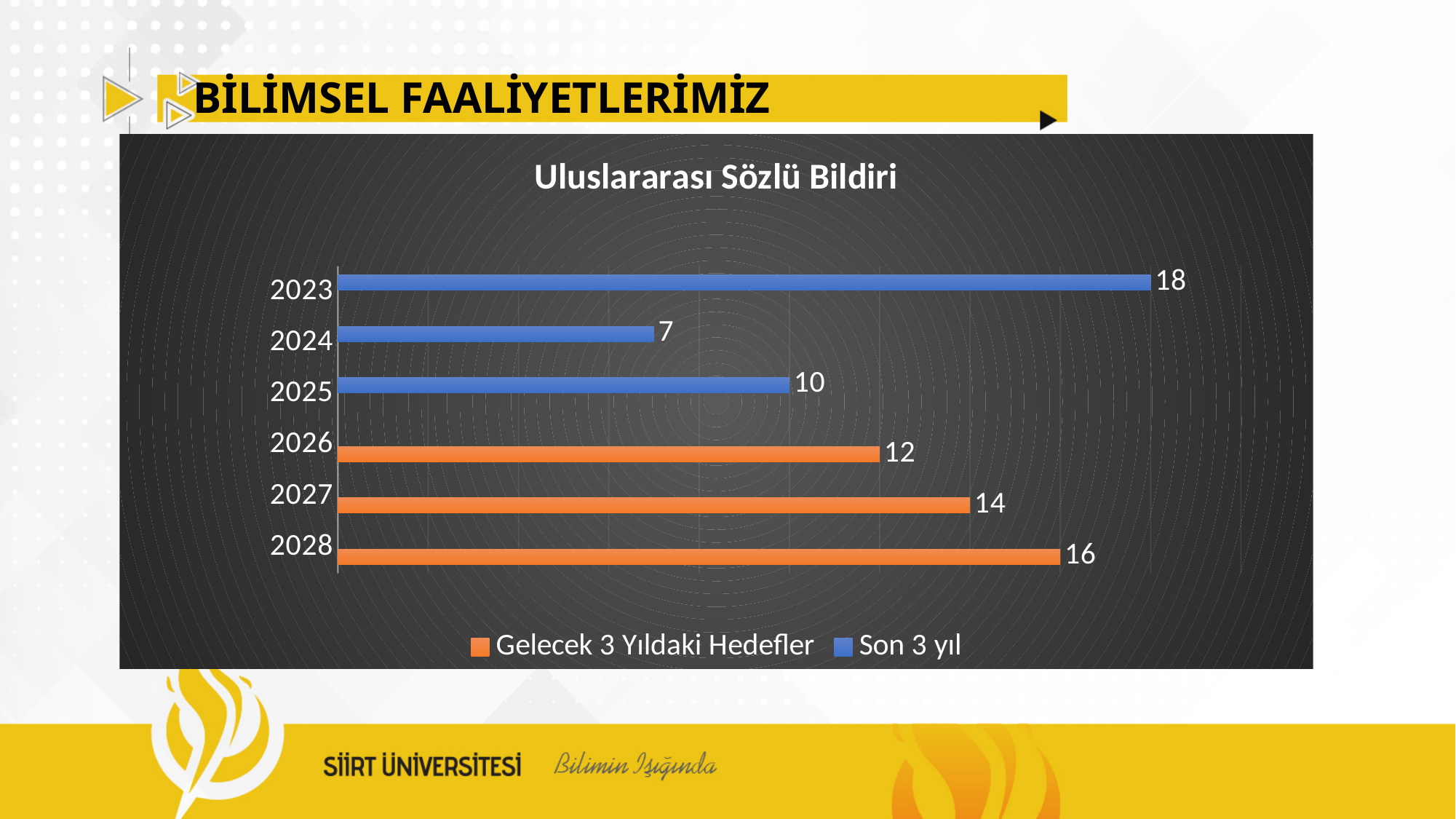
What is the value for 2026? 12 Which series is shown in orange? Gelecek 3 Yıldaki Hedefler What kind of chart is this? Bar chart Which year has the lowest value? 2024 How many series does the legend list? 2 What is the value for 2024? 7 Which is larger, the value for 2025 or the value for 2027? 2027 What is the value for 2028? 16 What is the difference between the values for 2023 and 2024? 11 What is the value for 2023 in the Uluslararası Sözlü Bildiri chart? 18 Which year has the highest value? 2023 How many years are shown on the chart? 6